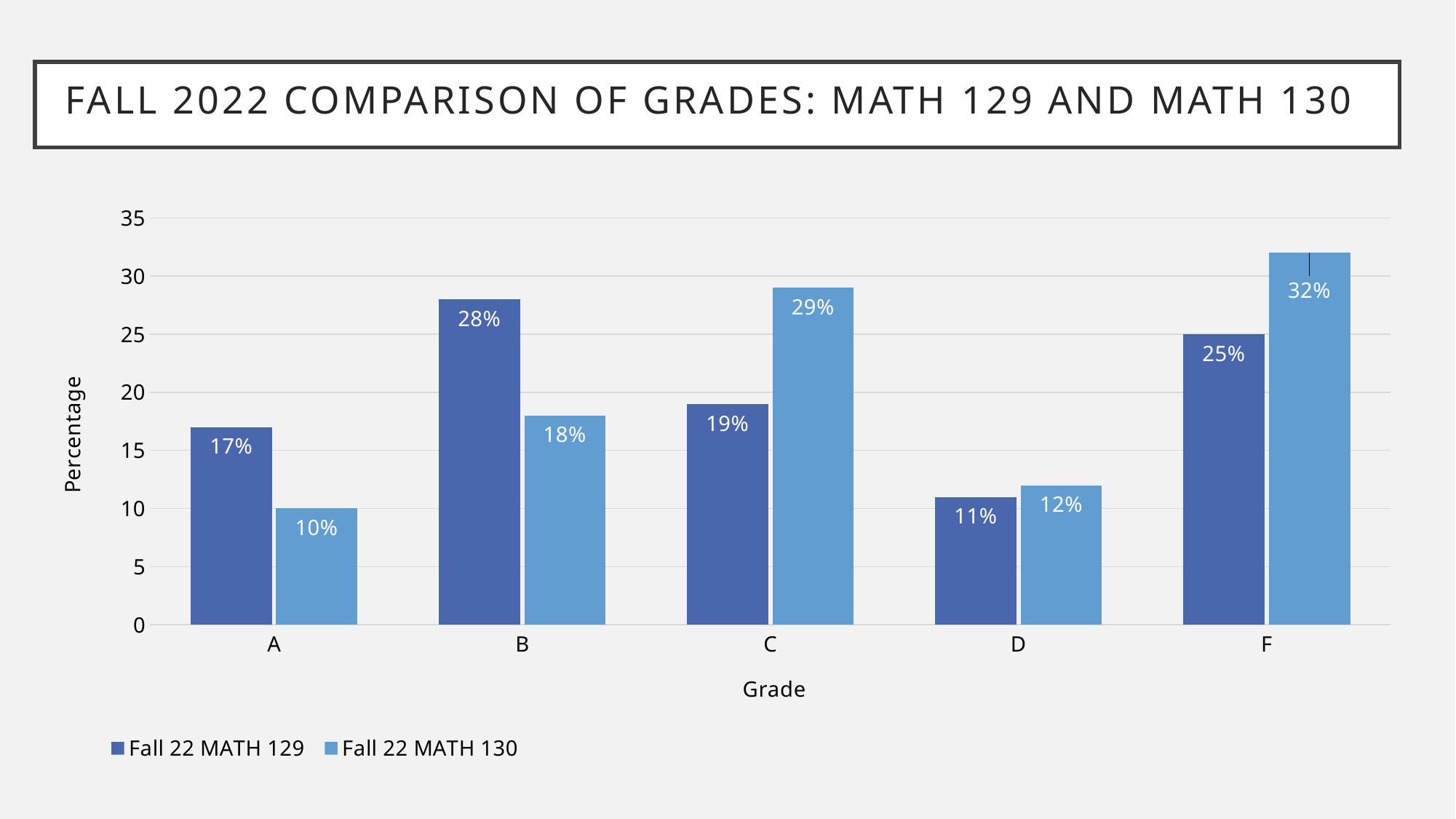
Which grade has the highest value for Fall 22 MATH 130? F What is the label of the y axis? Percentage What percentage of Fall 22 MATH 129 students received a grade of B? 28% How many grade categories are shown on the x axis? 5 What is the value for grade A in the Fall 22 MATH 130 series? 10% For grade B, which series has the larger value, Fall 22 MATH 129 or Fall 22 MATH 130? Fall 22 MATH 129 What is the difference between the Fall 22 MATH 130 and Fall 22 MATH 129 values for grade C? 10% Is the Fall 22 MATH 130 value for grade F greater or less than 30? greater What percentage of Fall 22 MATH 130 students received a grade of C? 29% Which grade has the lowest value for Fall 22 MATH 129? D What kind of chart is shown on the slide? Bar chart How many series does the legend list? 2